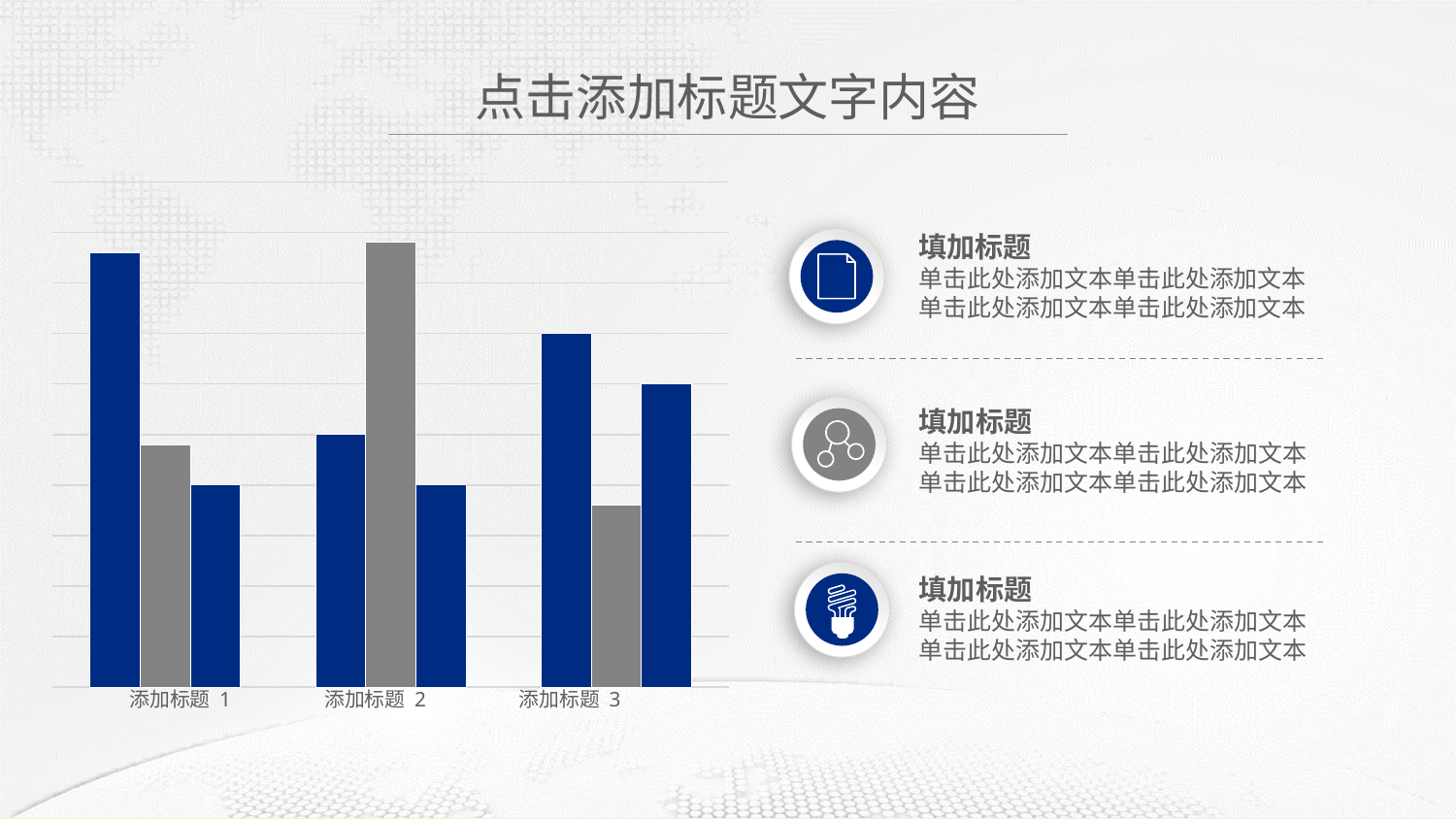
What colour is the middle bar in each category of the chart? Gray Is the first (leftmost) bar taller in 添加标题 1 or in 添加标题 3? 添加标题 1 How many bars are plotted for each category in the bar chart? 3 In the category 添加标题 2, which bar is the tallest? The middle (gray) bar In the category 添加标题 2, which bar is the shortest? The third (rightmost) bar How many categories are shown on the x axis of the bar chart? 3 In the category 添加标题 3, which bar is the shortest? The middle (gray) bar Is the third (rightmost) bar taller in 添加标题 1 or in 添加标题 3? 添加标题 3 In the category 添加标题 1, which bar is the tallest? The first (leftmost) bar What kind of chart is shown on the left of the slide? Bar chart Is the gray bar taller in 添加标题 1 or in 添加标题 2? 添加标题 2 Which category contains the tallest single bar in the chart? 添加标题 2